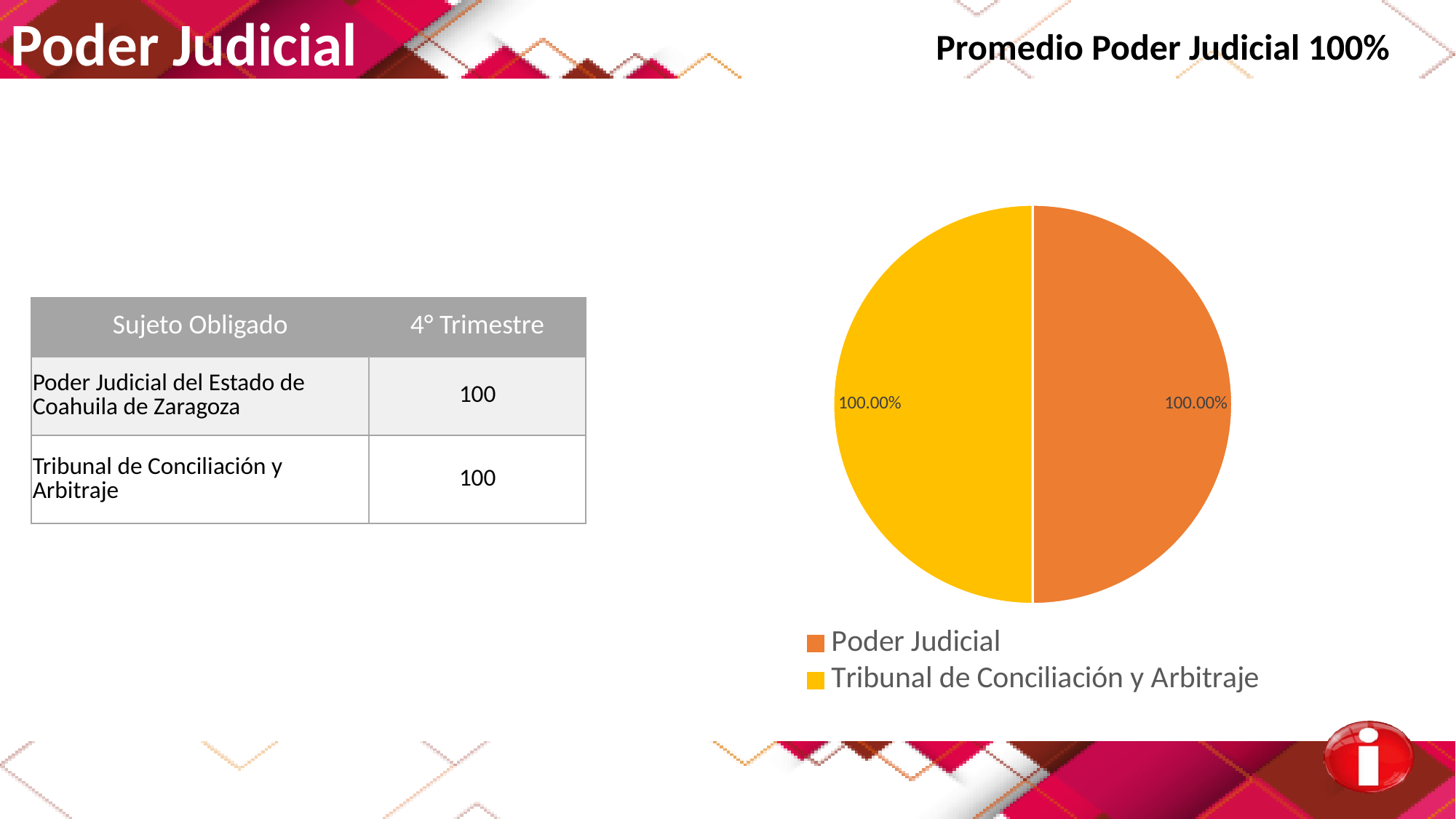
What data label is shown on the Tribunal de Conciliación y Arbitraje slice of the pie chart? 100.00% Which colour represents Poder Judicial in the pie chart? orange How many entries does the legend of the pie chart list? 2 How many slices does the pie chart have? 2 What is the difference between the data labels of the Poder Judicial slice and the Tribunal de Conciliación y Arbitraje slice? 0.00% What kind of chart is shown on the slide? pie chart Is the data label on the Poder Judicial slice greater or less than 50%? greater What data label is shown on the Poder Judicial slice of the pie chart? 100.00% Which legend entry is shown in yellow in the pie chart? Tribunal de Conciliación y Arbitraje